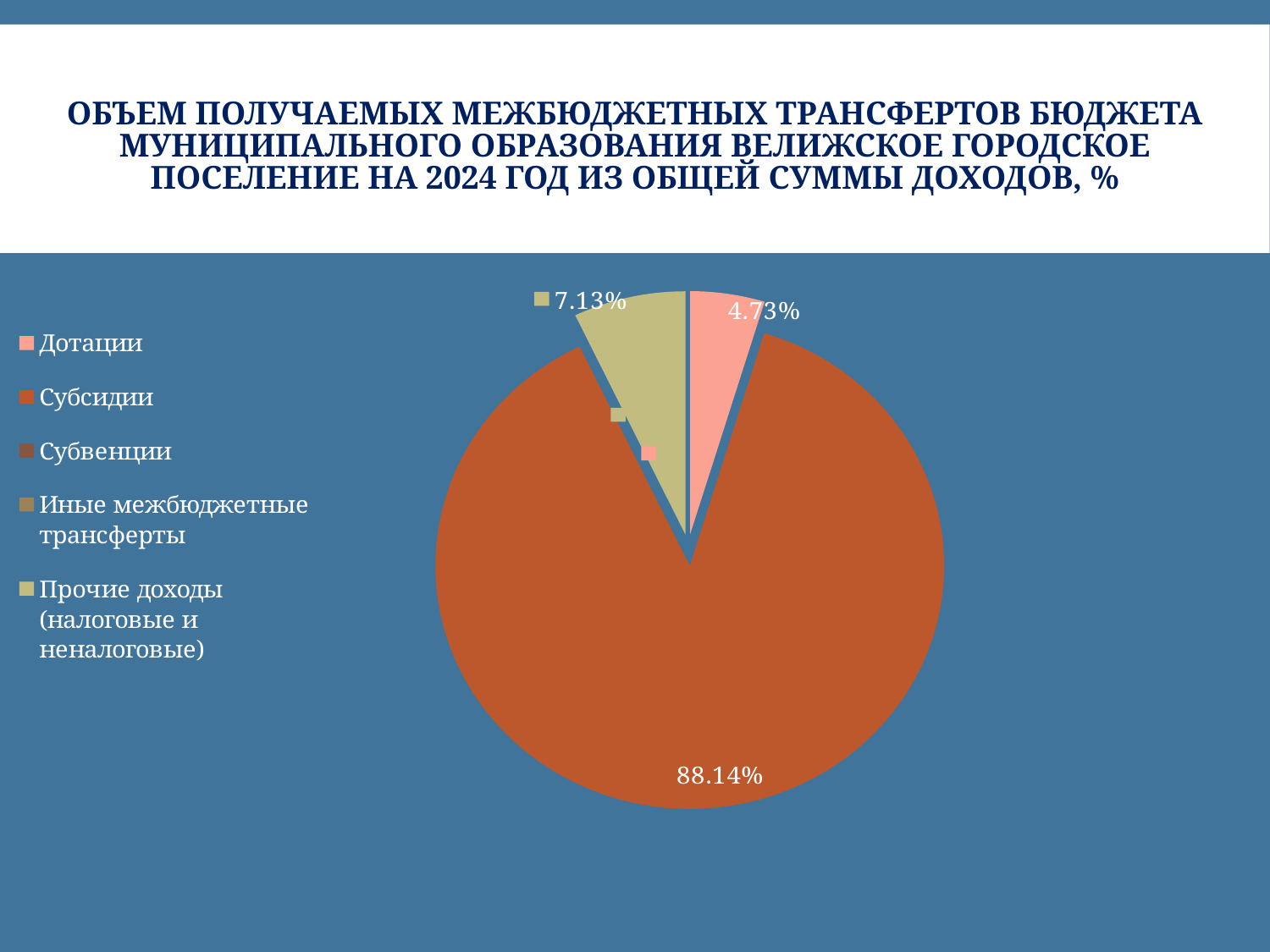
What percentage is shown for Прочие доходы (налоговые и неналоговые) in the pie chart? 7.13% For which year does the chart title say the data is given? 2024 What is the difference in percentage points between Субсидии and Дотации? 83.41 What percentage is shown for Субсидии in the pie chart? 88.14% Which legend entry is shown in pink in the pie chart? Дотации What is the difference in percentage points between Прочие доходы (налоговые и неналоговые) and Дотации? 2.40 What percentage is shown for Дотации in the pie chart? 4.73% What kind of chart is shown on the slide? pie chart Which is larger in the pie chart: Дотации or Прочие доходы (налоговые и неналоговые)? Прочие доходы (налоговые и неналоговые) Which category has the largest slice in the pie chart? Субсидии What share of the pie does the Субсидии slice represent? 88.14% How many entries does the legend of the pie chart list? 5